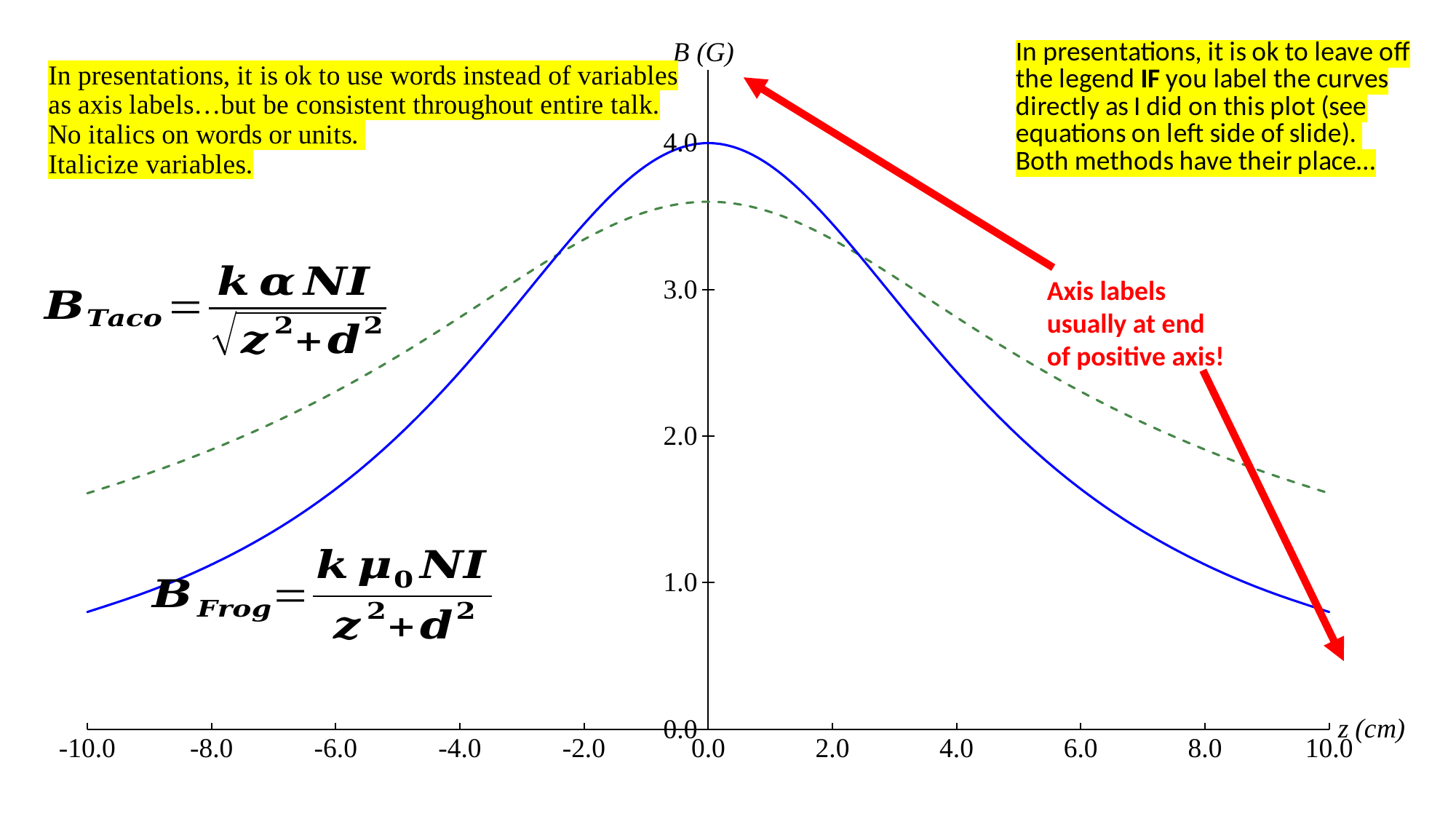
Is the value of the B_Taco curve at z = -10.0 greater or less than 2.0? less Which curve is drawn with a dashed line, B_Taco or B_Frog? B_Taco At z = 6.0, which curve has the higher value, B_Taco or B_Frog? B_Taco Is the value of the B_Frog curve at z = 10.0 greater or less than 1.0? less How many curves are plotted on the chart? 2 Is the value of the B_Taco curve at z = 0.0 greater or less than 3.0? greater What kind of chart is shown on the slide? line chart Do the curves rise or fall as z increases from 0.0 to 10.0? fall What is the peak value of the B_Frog curve at z = 0.0? 4.0 Which curve reaches the higher peak value, B_Taco or B_Frog? B_Frog What is the label on the vertical axis of the chart? B (G) Do the curves rise or fall as z increases from -10.0 to 0.0? rise